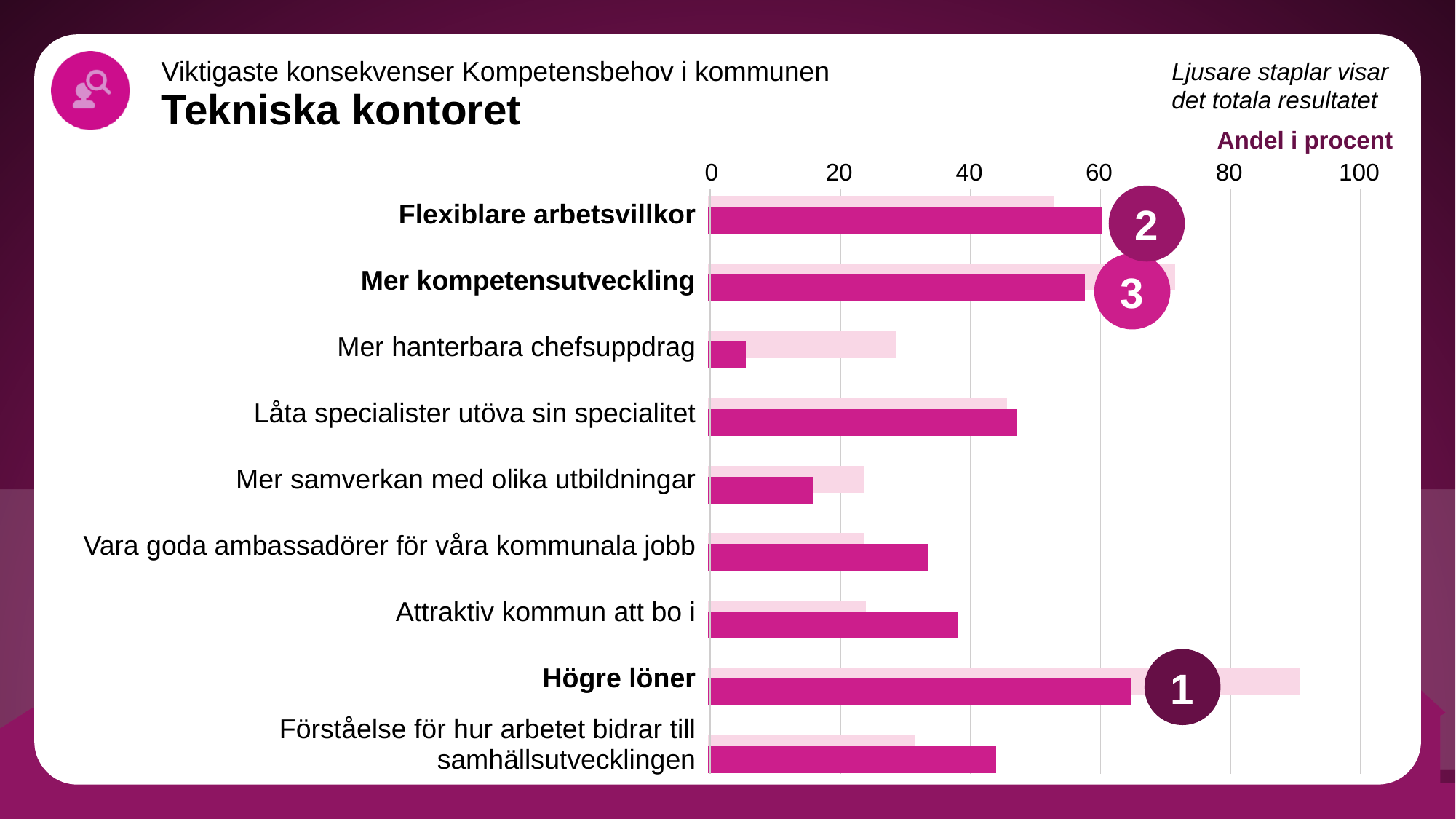
According to the note on the slide, what do the lighter bars show? det totala resultatet Which category is marked with the number 1 on the chart? Högre löner Which category has the longest dark bar? Högre löner Is the dark bar for Attraktiv kommun att bo i greater or less than 40? less Is the dark bar for Mer hanterbara chefsuppdrag greater or less than 20? less Which category has the shortest dark bar? Mer hanterbara chefsuppdrag For Mer hanterbara chefsuppdrag, which bar is longer: the dark bar or the light bar? the light bar Which has the longer dark bar: Flexiblare arbetsvillkor or Mer samverkan med olika utbildningar? Flexiblare arbetsvillkor Is the dark bar for Högre löner greater or less than 60? greater What kind of chart is shown on the slide? bar chart How many categories are plotted on the chart? 9